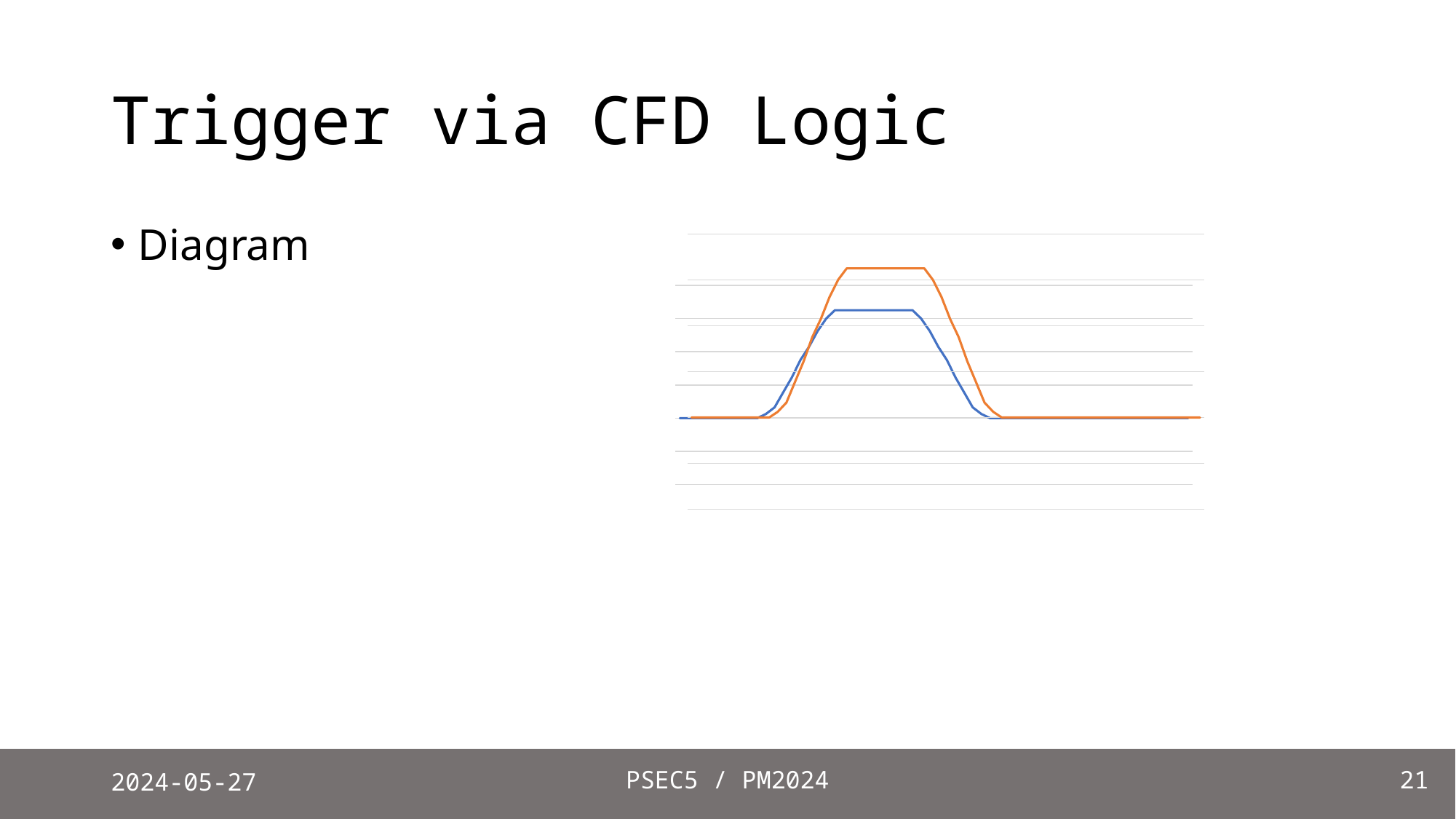
Does the chart show a legend? no Which line reaches a higher peak, the orange line or the blue line? orange What colours are the two lines on the chart? blue and orange How many lines are plotted on the chart? 2 What kind of chart is shown on the slide? line chart Which line has the wider plateau at its peak, the orange line or the blue line? orange